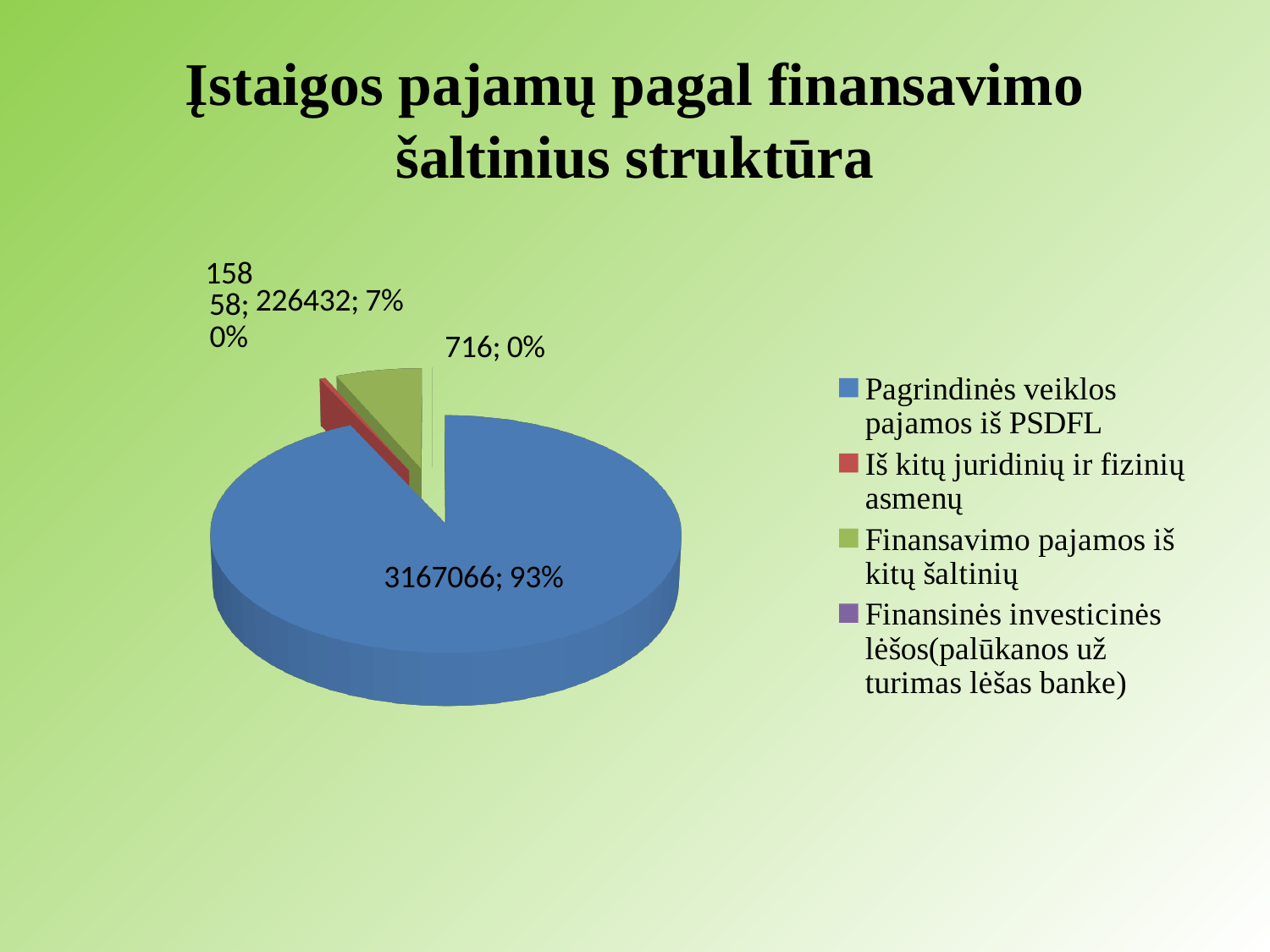
What is the value shown for Pagrindinės veiklos pajamos iš PSDFL? 3167066 How many entries does the legend list? 4 What is the difference between the values for Pagrindinės veiklos pajamos iš PSDFL and Finansavimo pajamos iš kitų šaltinių? 2940634 What share of the pie does Pagrindinės veiklos pajamos iš PSDFL represent? 93% Which category has the largest slice of the pie? Pagrindinės veiklos pajamos iš PSDFL What colour is the slice for Pagrindinės veiklos pajamos iš PSDFL? blue What is the value shown for Finansinės investicinės lėšos (palūkanos už turimas lėšas banke)? 716 How many slices does the pie chart have? 4 What is the value shown for Finansavimo pajamos iš kitų šaltinių? 226432 What share of the pie does Finansavimo pajamos iš kitų šaltinių represent? 7% What kind of chart is shown on the slide? pie chart Which category has the smallest slice of the pie? Finansinės investicinės lėšos (palūkanos už turimas lėšas banke)